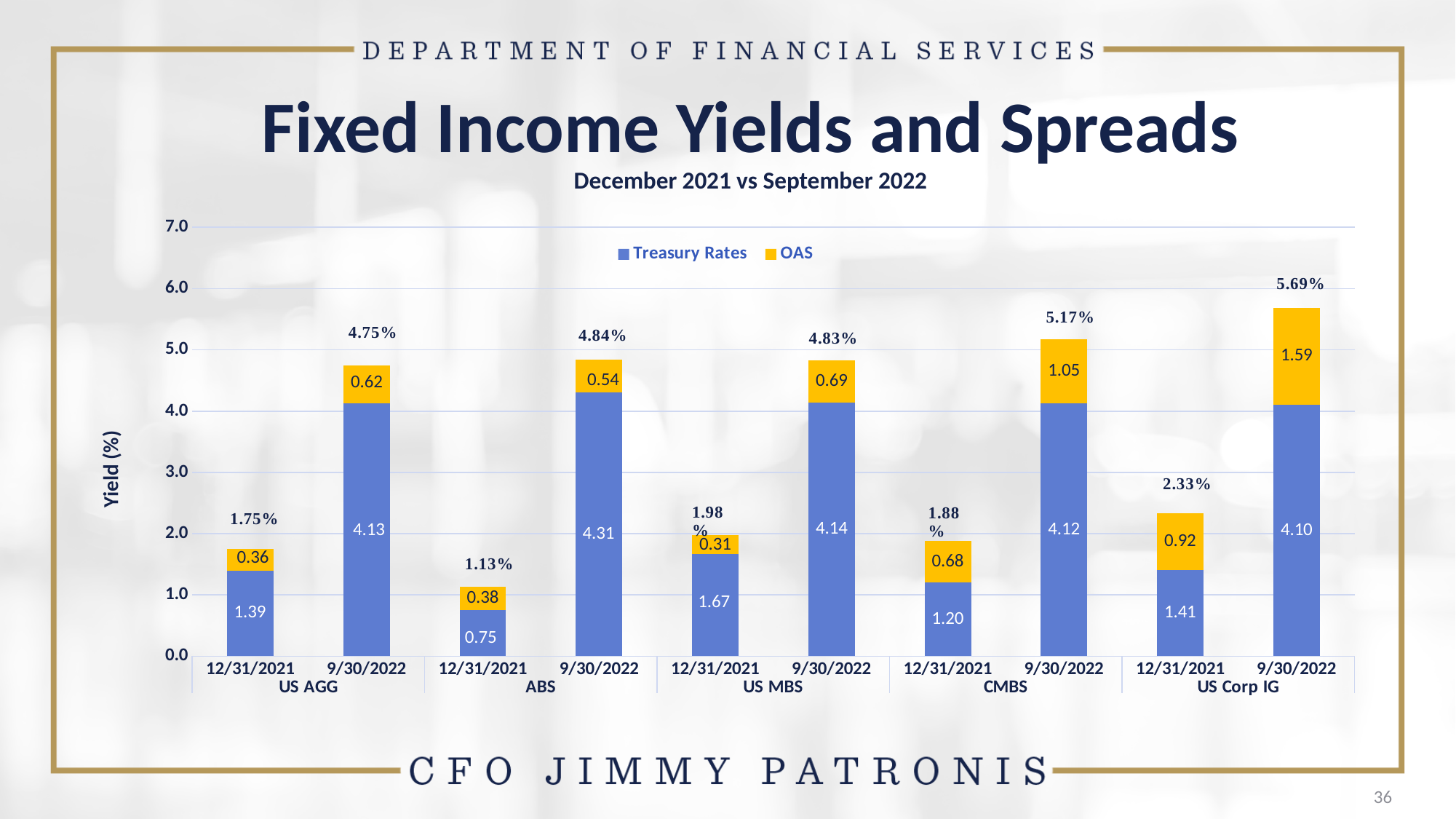
Is the total yield for US Corp IG on 9/30/2022 greater or less than 5.0? greater How many bars are plotted in the chart? 10 What is the label on the vertical axis? Yield (%) Which is larger, the Treasury Rates value for ABS on 9/30/2022 or for US MBS on 9/30/2022? ABS 9/30/2022 Which bar has the lowest total yield? ABS 12/31/2021 Which bar has the highest total yield? US Corp IG 9/30/2022 What kind of chart is shown on the slide? Stacked bar chart What is the total yield shown above the CMBS bar for 12/31/2021? 1.88% What is the OAS value for US Corp IG on 9/30/2022? 1.59 What is the Treasury Rates value for US AGG on 9/30/2022? 4.13 What is the difference between the OAS for CMBS on 9/30/2022 and on 12/31/2021? 0.37 How many series does the legend list? 2